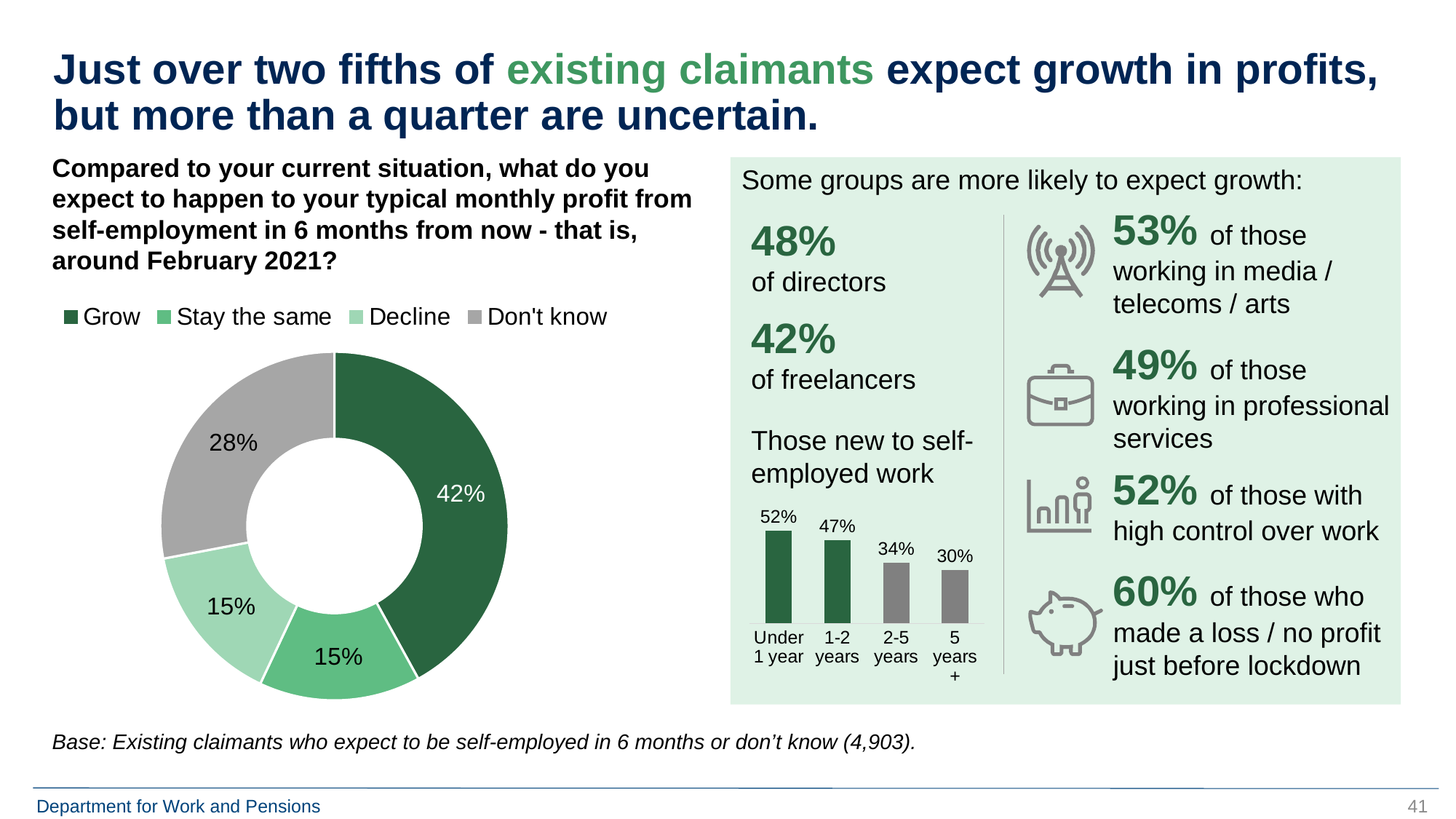
In the donut chart on the left, which response has the largest share? Grow In the donut chart on the left, what share of existing claimants expect their profit to grow? 42% In the bar chart titled 'Those new to self-employed work', what is the value for 'Under 1 year'? 52% What type of chart is shown on the left of the slide? Donut (pie) chart In the bar chart titled 'Those new to self-employed work', what is the value for '5 years +'? 30% In the donut chart on the left, what share answered 'Don't know'? 28% In the donut chart on the left, how many entries does the legend list? 4 In the bar chart titled 'Those new to self-employed work', how many categories are shown? 4 In the bar chart titled 'Those new to self-employed work', which category has the lowest value? 5 years + In the donut chart on the left, which colour represents 'Don't know'? Grey In the donut chart on the left, what is the difference in percentage points between 'Grow' and 'Don't know'? 14 percentage points In the bar chart titled 'Those new to self-employed work', do the values rise or fall as time in self-employment increases? Fall